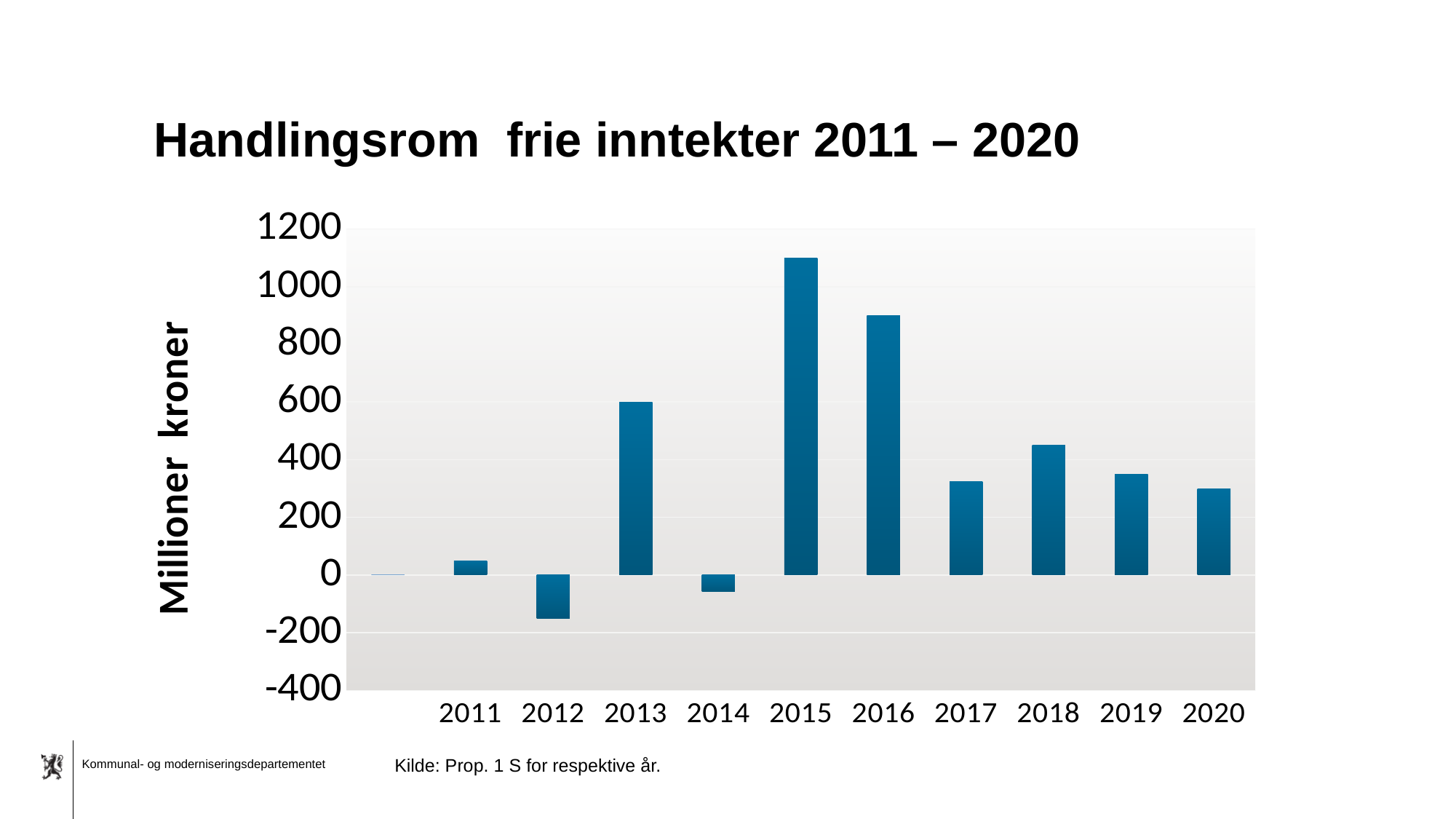
Which year has the highest value? 2015 Is the value for 2012 greater or less than 0? less Do the values rise or fall from 2015 to 2017? fall What is the title of the chart? Handlingsrom frie inntekter 2011 – 2020 Which year has the lowest value? 2012 Is the value for 2017 greater or less than 400? less Which is larger, the value for 2018 or the value for 2019? 2018 Is the value for 2016 greater or less than 800? greater What is the label on the vertical axis? Millioner kroner Which is larger, the value for 2013 or the value for 2016? 2016 What kind of chart is shown on the slide? bar chart